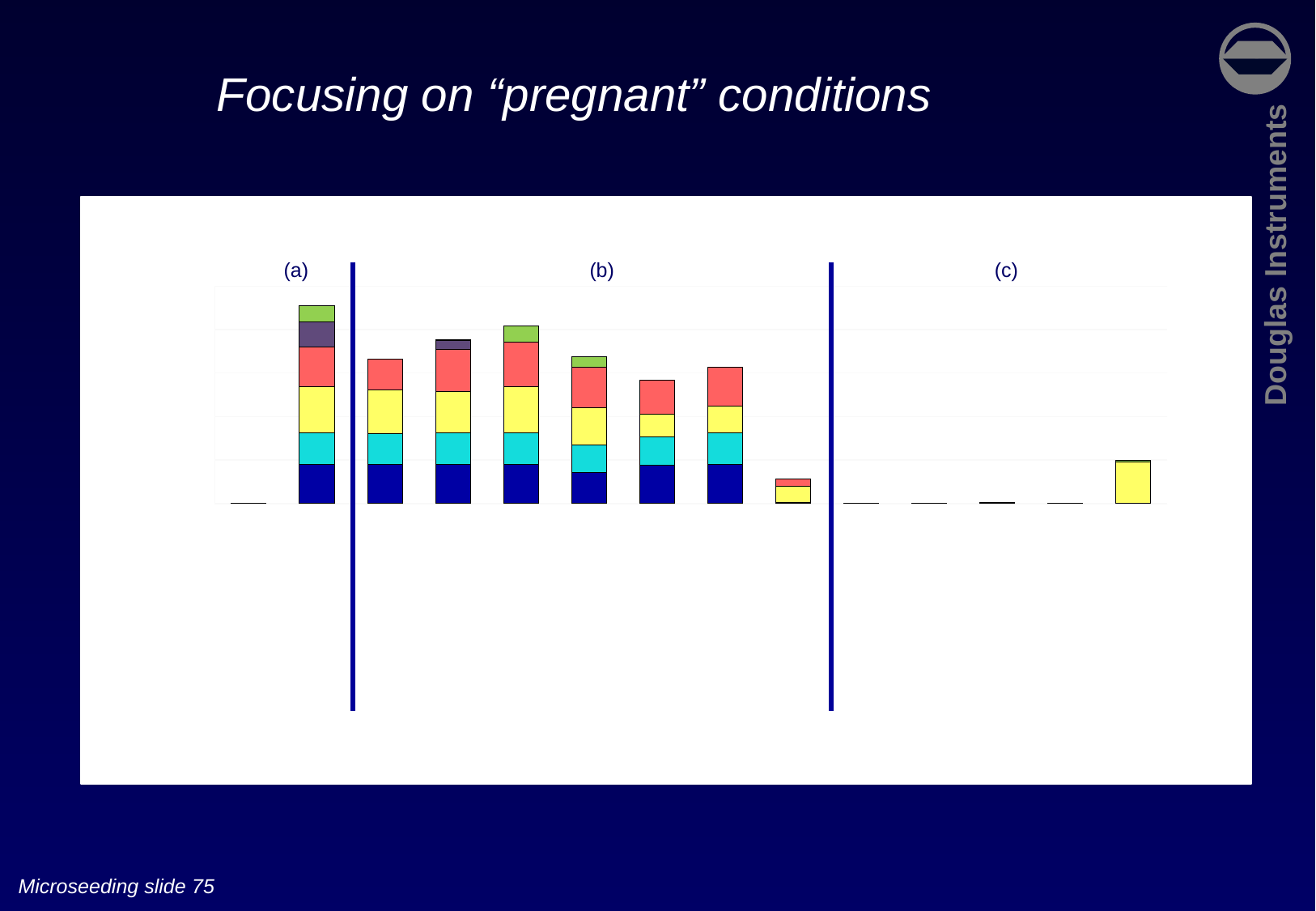
What are the labels of the three sections of the chart? (a), (b), (c) Which section of the chart contains the most stacked bars? (b) How many stacked bars are in section (b)? 7 In section (b), which bar is the shortest? the seventh (last) bar What colour is the bottom segment of the stacked bars in section (b)? dark blue In section (b), is the first bar or the second bar taller? the second bar How many labelled sections is the chart divided into? 3 Is the tallest bar in section (a) taller or shorter than the tallest bar in section (b)? taller Which section of the chart contains the tallest stacked bar? (a) In section (c), how many bars have a visible stacked height? 1 What kind of chart is shown on the slide? bar chart In section (b), which bar is the tallest? the third bar